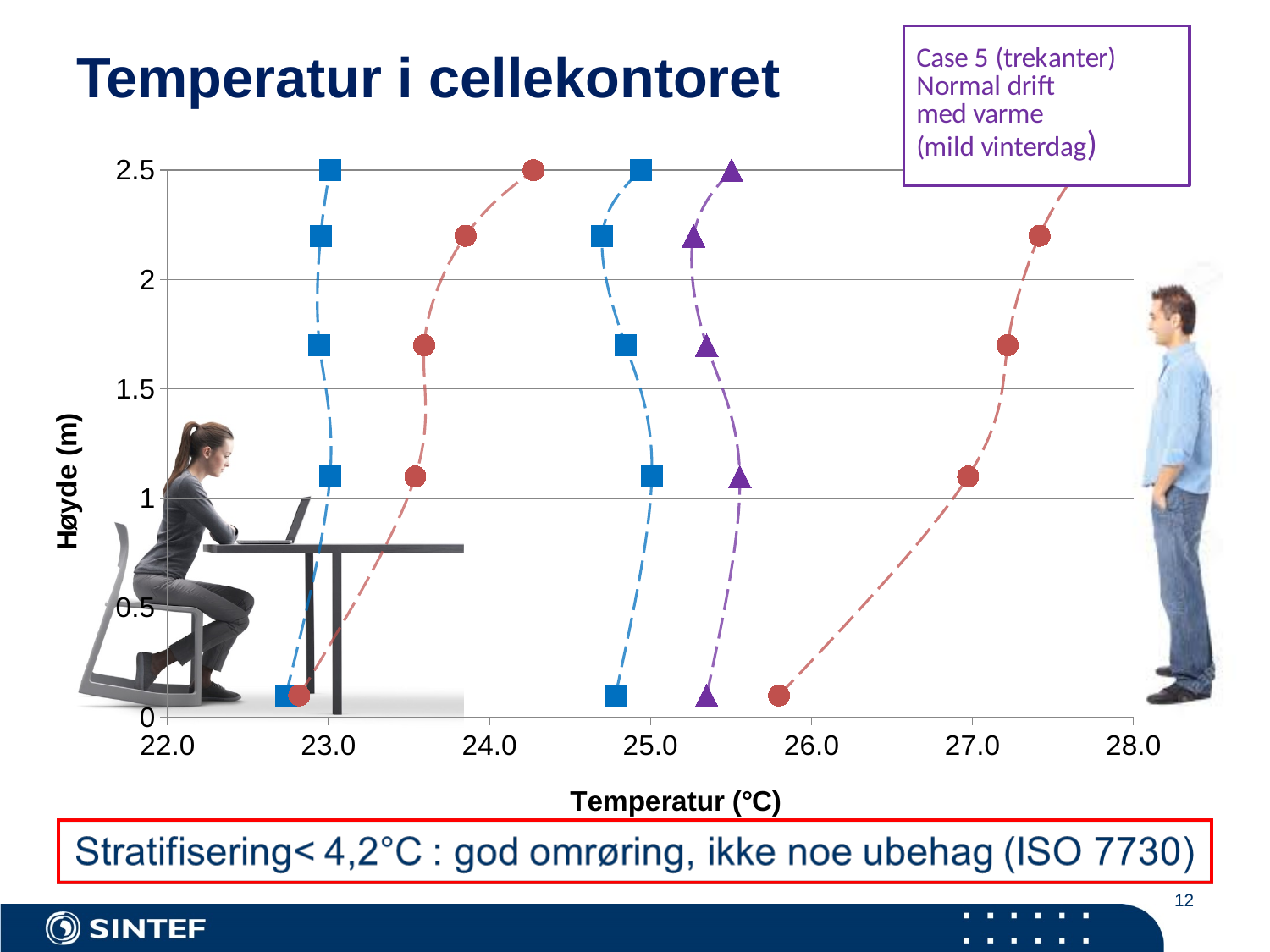
For the rightmost red-circle series, does the temperature rise or fall as height increases? rise What kind of chart is shown on the slide? scatter chart How many data points does the triangle series (Case 5) have? 5 At a height of 2.5 m, which has the higher temperature: the triangle series (Case 5) or the leftmost blue-square series? the triangle series (Case 5) Is the temperature of the rightmost red-circle series at its lowest point (near 0 m) greater or less than 26.0? less Is the temperature of the leftmost red-circle series at a height of 2.5 m greater or less than 24.0? greater What is the title of the chart? Temperatur i cellekontoret Is the temperature of the rightmost red-circle series at a height of 2.2 m greater or less than 27.0? greater Which series has the highest temperature at a height of about 1 m? the rightmost red-circle series According to the text box, which marker shape represents Case 5? triangles (trekanter)